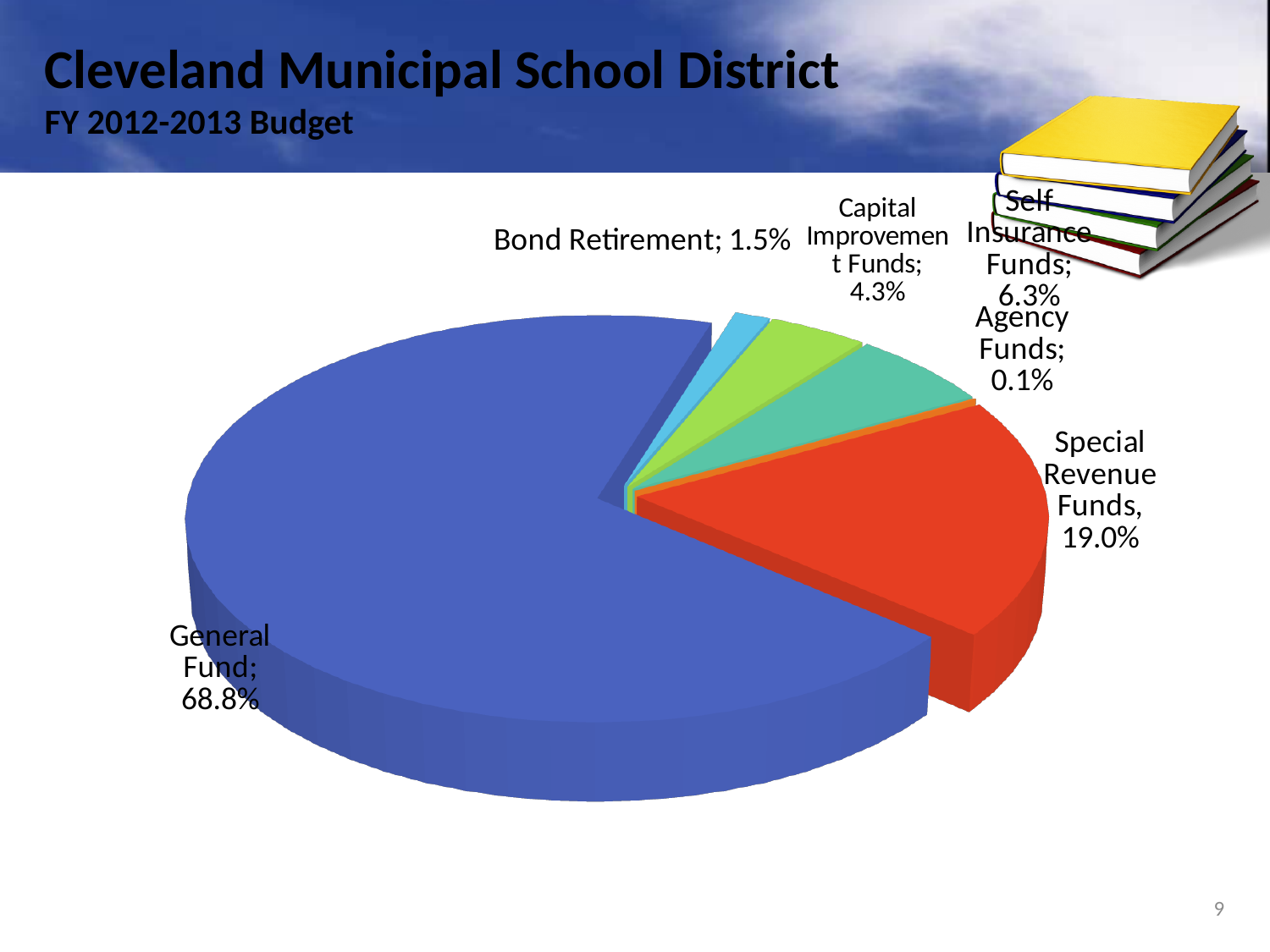
What is the difference between the General Fund share and the Special Revenue Funds share? 49.8% What share of the budget is Capital Improvement Funds? 4.3% What share of the budget is Self Insurance Funds? 6.3% What share of the budget is the General Fund? 68.8% What share of the budget is Bond Retirement? 1.5% How many slices does the pie chart have? 6 What kind of chart is shown on the slide? Pie chart Which is larger, Self Insurance Funds or Capital Improvement Funds? Self Insurance Funds Which fund has the largest share of the budget? General Fund What share of the budget is Special Revenue Funds? 19.0% Which fund has the smallest share of the budget? Agency Funds What share of the budget is Agency Funds? 0.1%